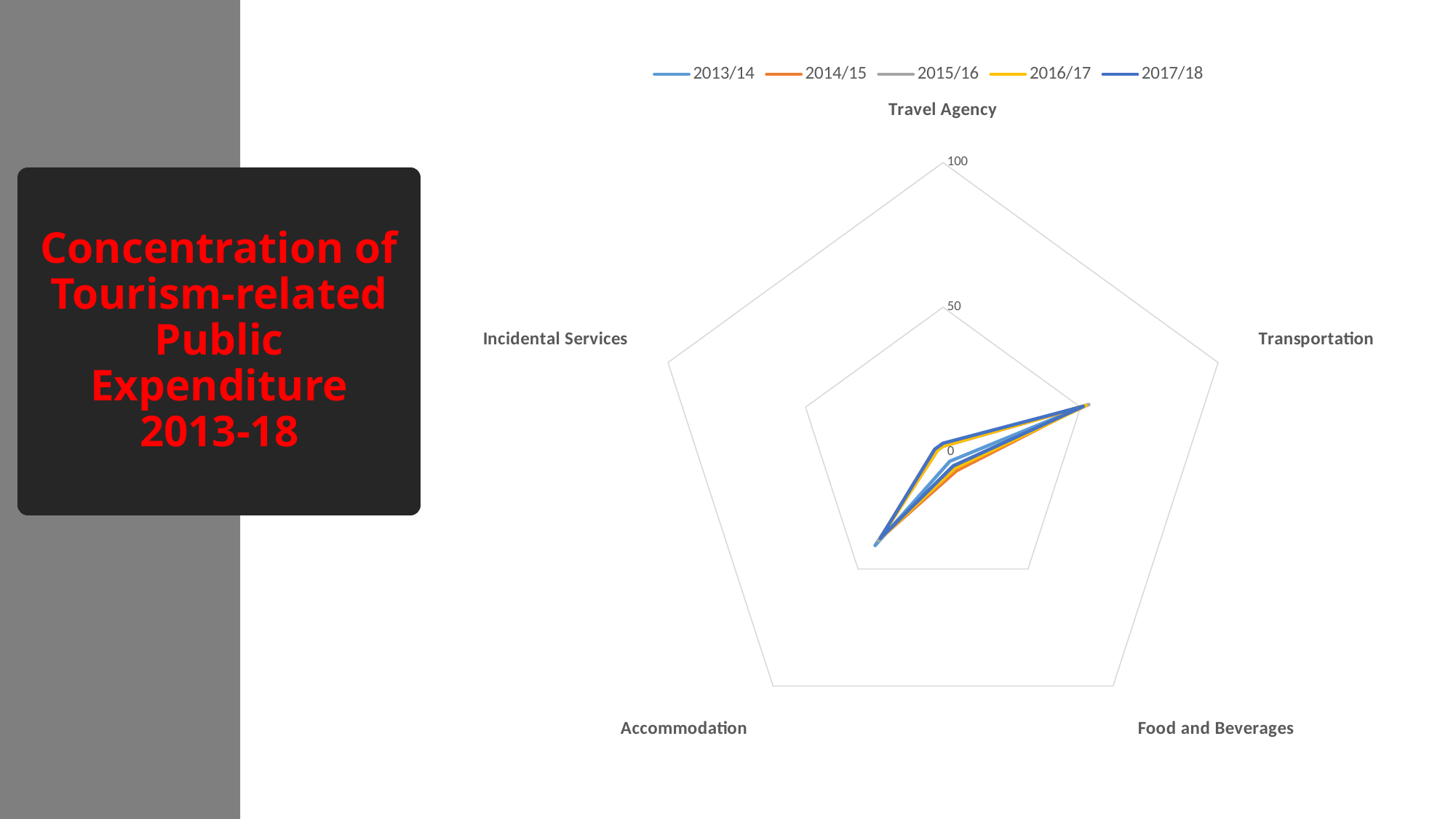
Which series is listed last in the legend? 2017/18 How many series does the legend list? 5 Is the value for Travel Agency in 2017/18 greater or less than 50? less How many categories (axes) does the radar chart have? 5 What is the maximum value shown on the radar chart's axis scale? 100 Is the value for Transportation in 2016/17 greater or less than 100? less Is the value for Incidental Services in 2013/14 greater or less than 50? less Which category has the highest values across the series? Transportation What kind of chart is shown on the slide? Radar chart Which is larger for 2013/14: Accommodation or Food and Beverages? Accommodation Which is larger for 2017/18: Transportation or Travel Agency? Transportation